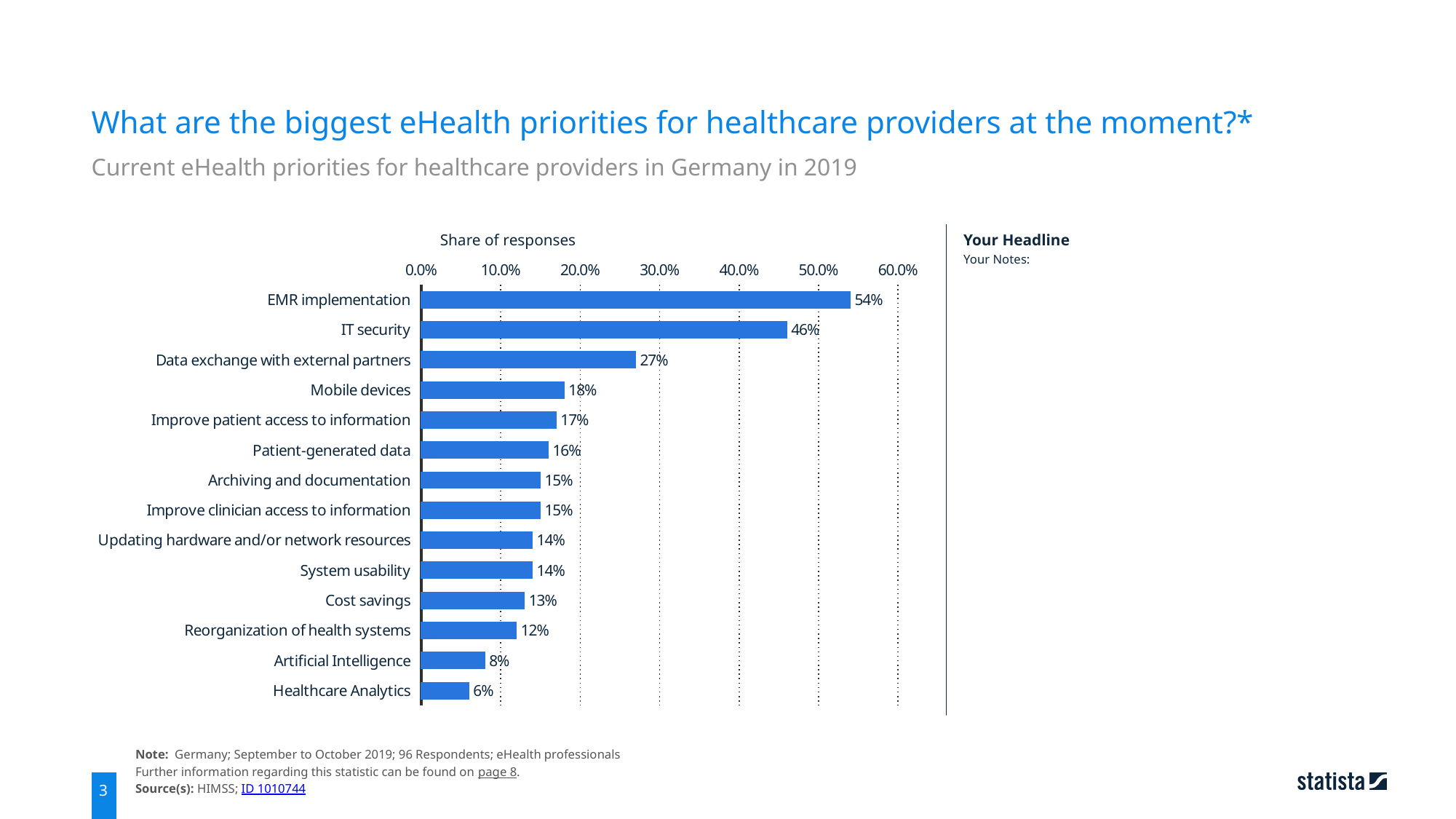
Which category has the highest share of responses? EMR implementation What is the share of responses for Mobile devices? 18% Is the value for IT security greater or less than 40.0%? greater How many categories are shown in the chart? 14 Which category has the lowest share of responses? Healthcare Analytics What is the share of responses for Artificial Intelligence? 8% What is the label of the value axis of the chart? Share of responses What kind of chart is shown on the slide? Bar chart What is the difference in share of responses between EMR implementation and IT security? 8% Which has a larger share of responses, Mobile devices or Reorganization of health systems? Mobile devices What is the difference in share of responses between Data exchange with external partners and Cost savings? 14% What is the share of responses for EMR implementation? 54%